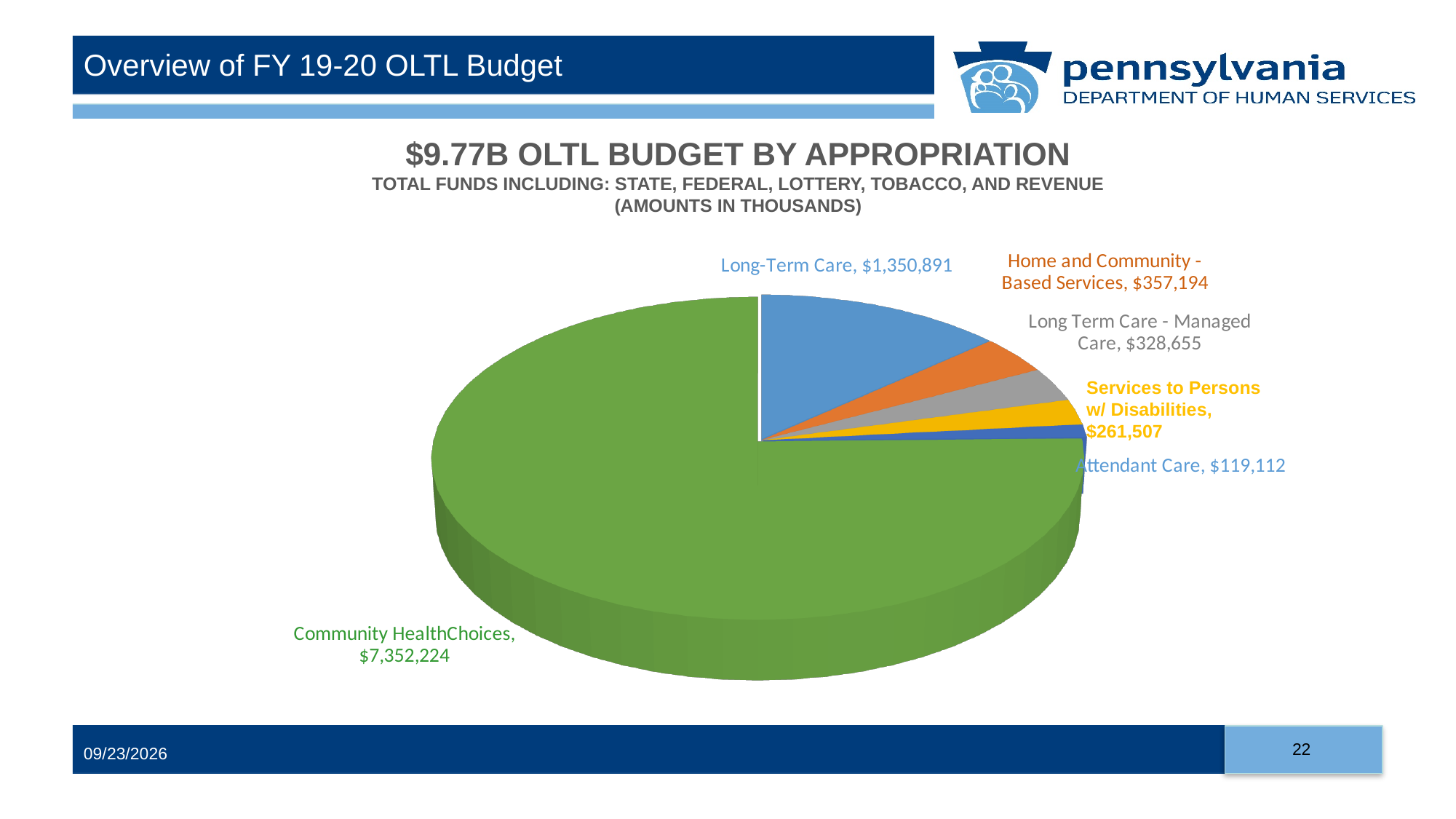
Which appropriation has the largest slice of the pie? Community HealthChoices What is the difference between Services to Persons w/ Disabilities and Attendant Care? $142,395 What colour is the Community HealthChoices slice? Green What kind of chart is shown on the slide? Pie chart How many appropriation categories are shown in the pie chart? 6 What is the value for Long-Term Care in the pie chart? $1,350,891 Which is larger, Long Term Care - Managed Care or Services to Persons w/ Disabilities? Long Term Care - Managed Care What is the value for Attendant Care? $119,112 What is the value for Home and Community-Based Services? $357,194 What is the value for Community HealthChoices in the pie chart? $7,352,224 Which appropriation has the smallest slice of the pie? Attendant Care What is the difference between Long-Term Care and Home and Community-Based Services? $993,697